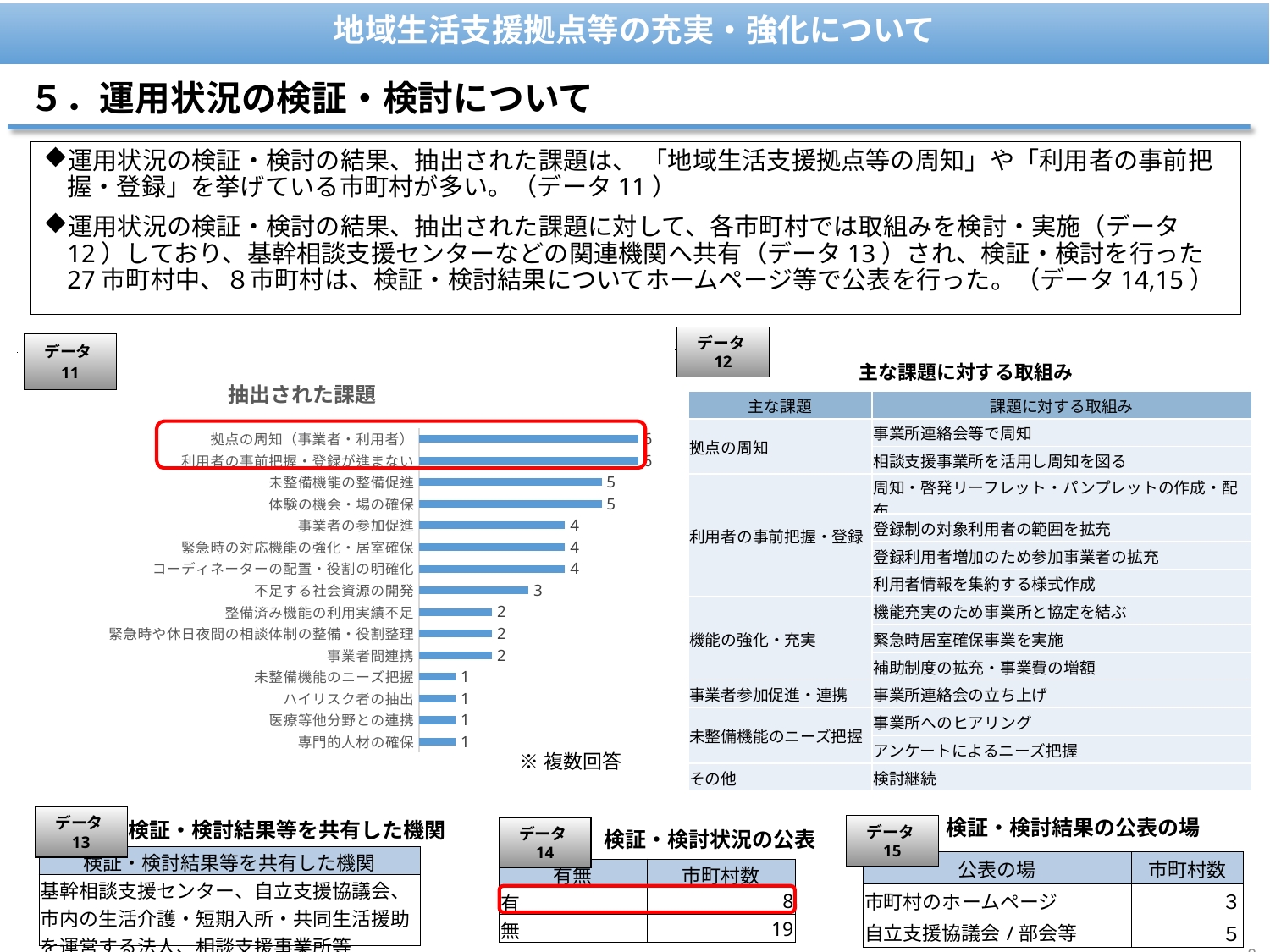
In the 抽出された課題 chart, what is the value for 事業者間連携? 2 In the 抽出された課題 chart, what is the value for 専門的人材の確保? 1 What type of chart is shown under データ 11? bar chart In the 抽出された課題 chart, what is the value for 体験の機会・場の確保? 5 In the 抽出された課題 chart, what is the value for 不足する社会資源の開発? 3 In the 抽出された課題 chart, what is the value for 未整備機能の整備促進? 5 In the 抽出された課題 chart, which is larger: 事業者の参加促進 or 事業者間連携? 事業者の参加促進 In the 抽出された課題 chart, which is larger: 整備済み機能の利用実績不足 or ハイリスク者の抽出? 整備済み機能の利用実績不足 What is the title of the chart under データ 11? 抽出された課題 In the 抽出された課題 chart, what is the value for コーディネーターの配置・役割の明確化? 4 How many categories are plotted in the 抽出された課題 chart? 15 In the 抽出された課題 chart, what is the difference between the values for 未整備機能の整備促進 and 不足する社会資源の開発? 2